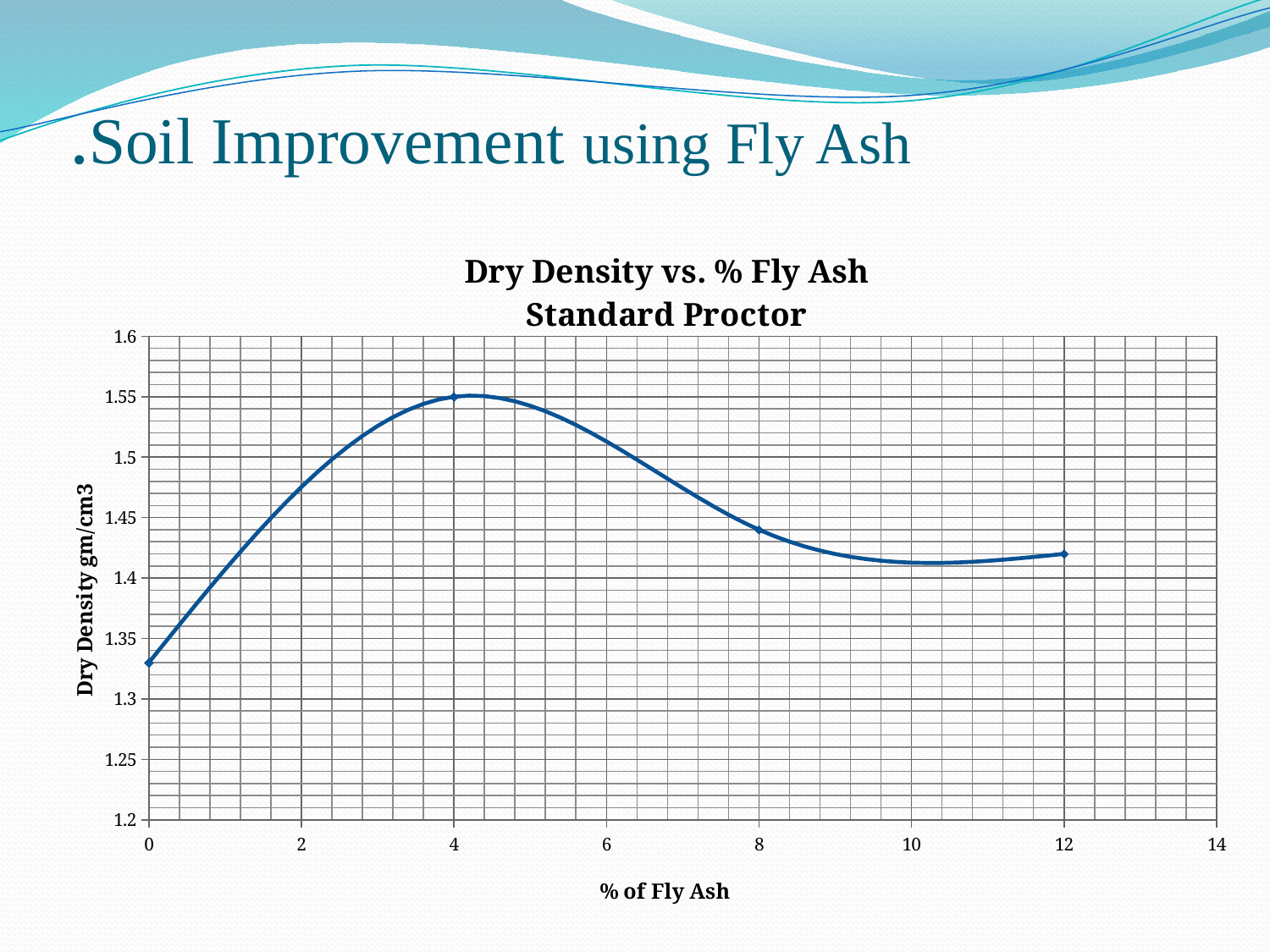
What is the label of the y axis? Dry Density gm/cm3 What kind of chart is shown on the slide? line chart Is the dry density at 8% fly ash greater or less than 1.45? less What is the title of the chart? Dry Density vs. % Fly Ash Standard Proctor How many data points are plotted on the line? 4 Does the dry density rise or fall between 4% and 8% fly ash? fall Is the dry density at 0% fly ash greater or less than 1.35? less At which % of fly ash is the dry density highest? 4 At which % of fly ash is the dry density lowest? 0 Is the dry density at 12% fly ash greater or less than 1.4? greater What is the dry density at 4% fly ash? 1.55 Which has the higher dry density, 0% fly ash or 12% fly ash? 12% fly ash